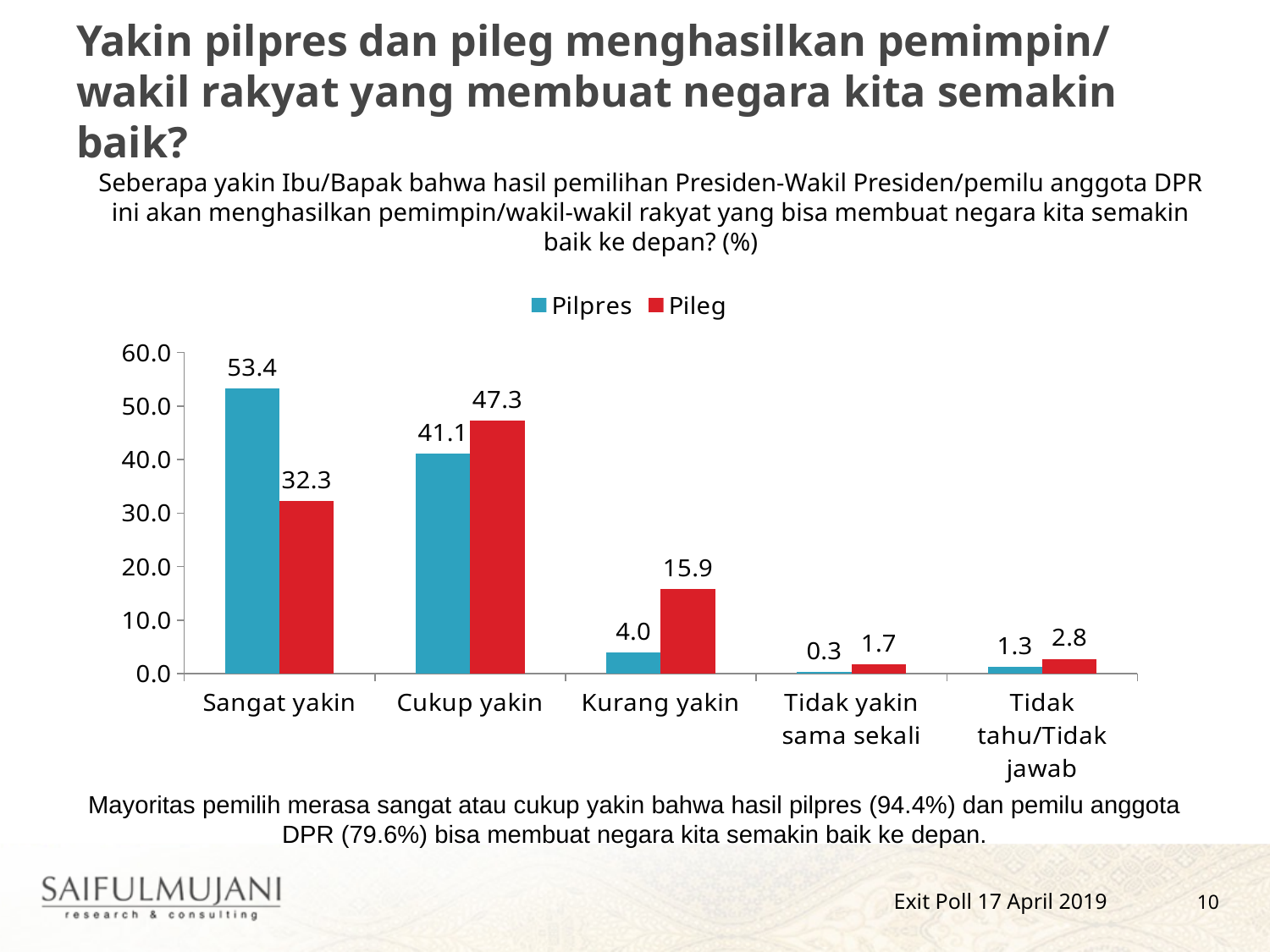
Which series is shown in red in the legend? Pileg How many series does the legend list? 2 What is the Pileg value for Kurang yakin? 15.9 What is the difference between the Pilpres and Pileg values for Sangat yakin? 21.1 Which is larger for Cukup yakin, Pilpres or Pileg? Pileg What is the Pilpres value for Tidak tahu/Tidak jawab? 1.3 What is the Pilpres value for Sangat yakin? 53.4 What kind of chart is shown on the slide? Bar chart How many categories are shown on the x axis? 5 Which category has the lowest Pileg value? Tidak yakin sama sekali Which category has the highest Pilpres value? Sangat yakin What is the Pileg value for Cukup yakin? 47.3